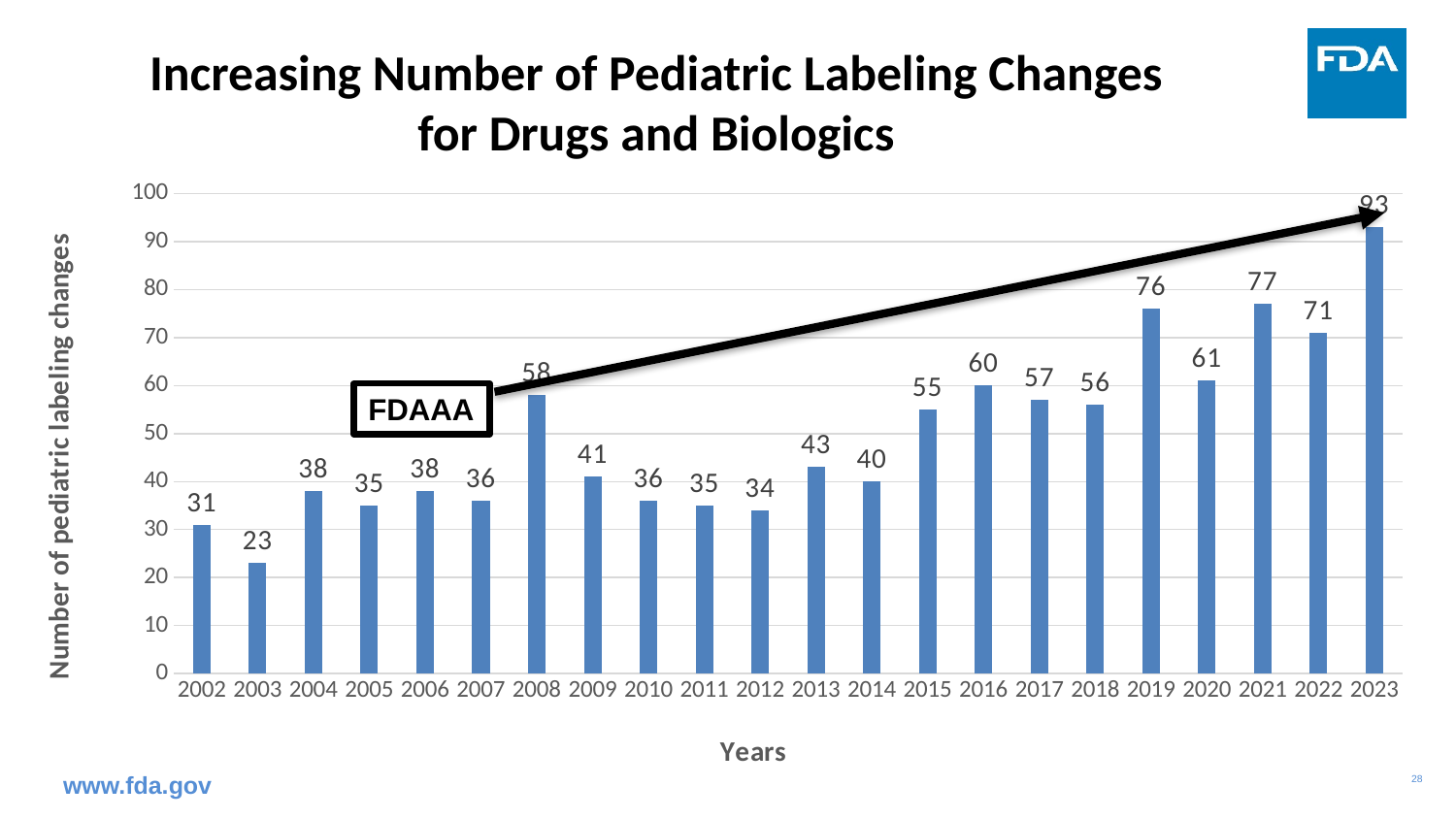
What is the difference between the values for 2021 and 2020? 16 What is the value shown for 2003? 23 How many pediatric labeling changes were there in 2008? 58 Which year has the lowest number of pediatric labeling changes? 2003 What text appears in the boxed annotation near the 2007 bar? FDAAA What is the number of pediatric labeling changes for 2019? 76 Which year has the highest number of pediatric labeling changes? 2023 What is the label of the y axis? Number of pediatric labeling changes What type of chart is shown on the slide? bar chart Is the value for 2023 greater or less than 90? greater How many years are shown on the x axis? 22 Which year has a larger value, 2016 or 2017? 2016